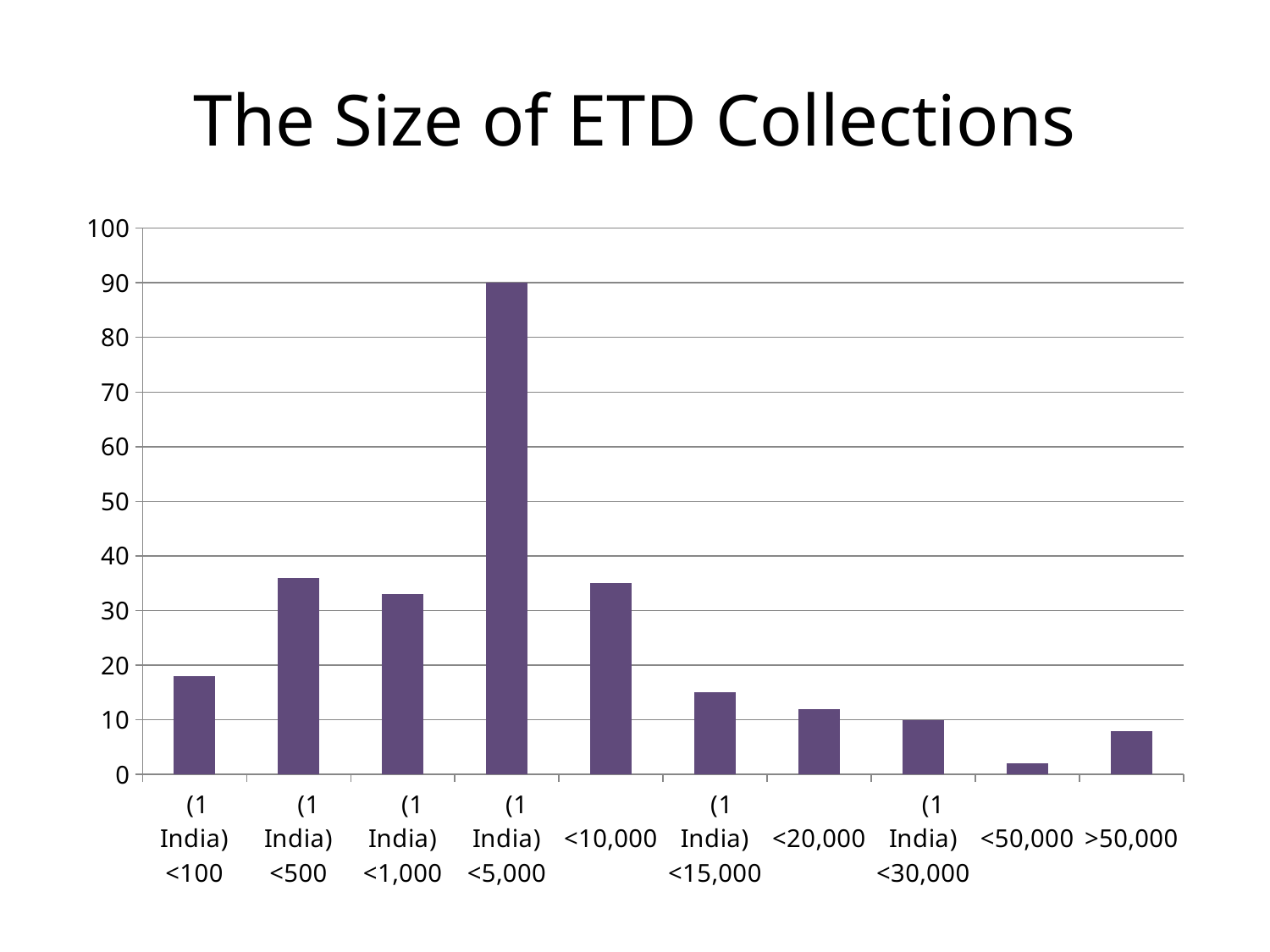
Is the value for >50,000 greater or less than 10? less What kind of chart is shown on the slide? bar chart Which is larger, the value for <10,000 or the value for <20,000? <10,000 Which category has the highest bar? (1 India) <5,000 What is the value for the (1 India) <30,000 category? 10 What is the title of the chart? The Size of ETD Collections Is the value for (1 India) <500 greater or less than 30? greater Which category has the lowest bar? <50,000 Is the value for <10,000 greater or less than 40? less How many categories are plotted along the x axis? 10 What is the value for the (1 India) <5,000 category? 90